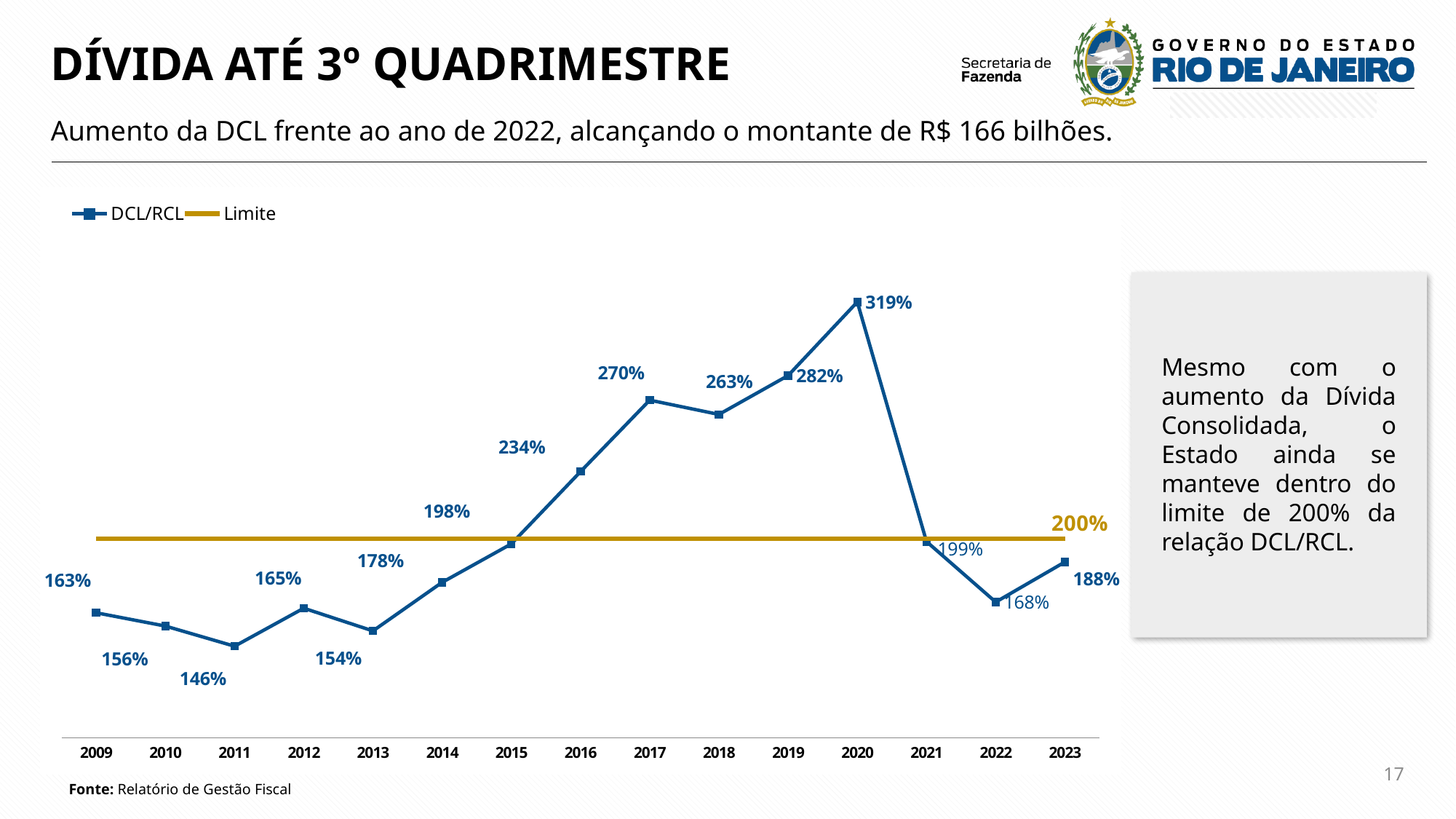
What value is the Limite line set at? 200% How many series does the legend list? 2 Which is larger, the DCL/RCL value for 2017 or for 2018? 2017 What is the DCL/RCL value for 2023? 188% What is the DCL/RCL value for 2020? 319% Which year has the highest DCL/RCL value? 2020 How many years are shown on the x axis? 15 Does the DCL/RCL value rise or fall from 2016 to 2017? Rise What is the DCL/RCL value for 2011? 146% Which year has the lowest DCL/RCL value? 2011 What is the difference between the DCL/RCL values for 2020 and 2021? 120% What kind of chart is shown on the slide? Line chart